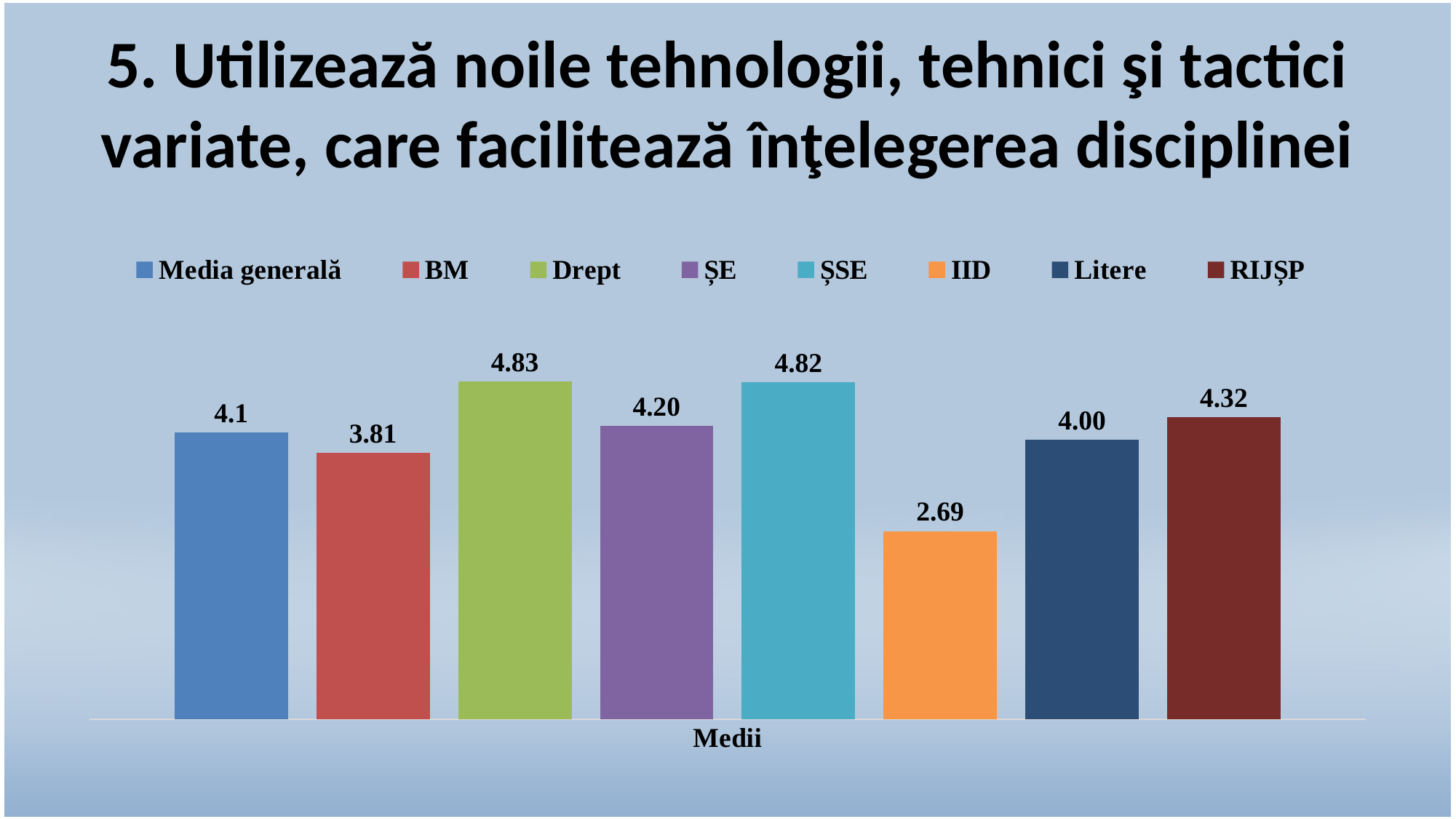
What is the value for Drept? 4.83 What is the value for RIJȘP? 4.32 How many series does the legend list? 8 What kind of chart is shown on the slide? Bar chart Which series has the lowest value? IID Which is larger, the value for BM or the value for Litere? Litere What is the difference between the values for RIJȘP and Litere? 0.32 What is the difference between the values for Drept and IID? 2.14 What is the value for Media generală? 4.1 Which is larger, the value for RIJȘP or the value for ȘE? RIJȘP What is the label on the x axis under the bars? Medii What is the value for IID? 2.69